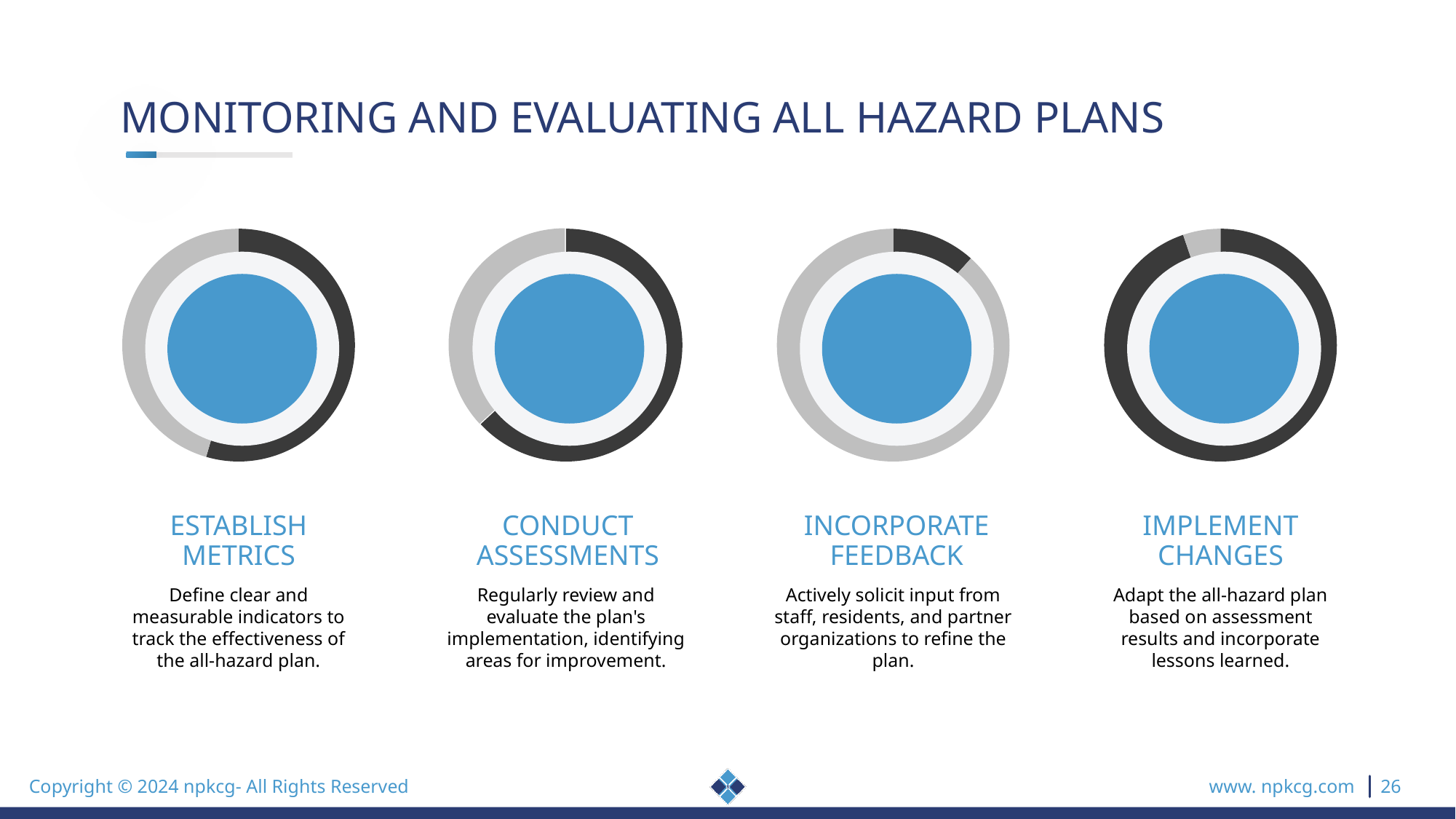
What is the title of the slide containing the donut charts? Monitoring and Evaluating All Hazard Plans Is the dark filled portion larger in the Incorporate Feedback chart or the Implement Changes chart? Implement Changes What kind of chart is shown above the label "Establish Metrics"? donut chart How many labelled categories do the donut charts on the slide represent? 4 Is the dark filled portion larger in the Conduct Assessments chart or the Incorporate Feedback chart? Conduct Assessments Is the dark filled portion larger in the Establish Metrics chart or the Implement Changes chart? Implement Changes Which category's donut chart is positioned leftmost on the slide? Establish Metrics Which of the four charts has the largest dark filled portion of its ring? Implement Changes Which of the four charts has the smallest dark filled portion of its ring? Incorporate Feedback How many donut charts are shown on the slide? 4